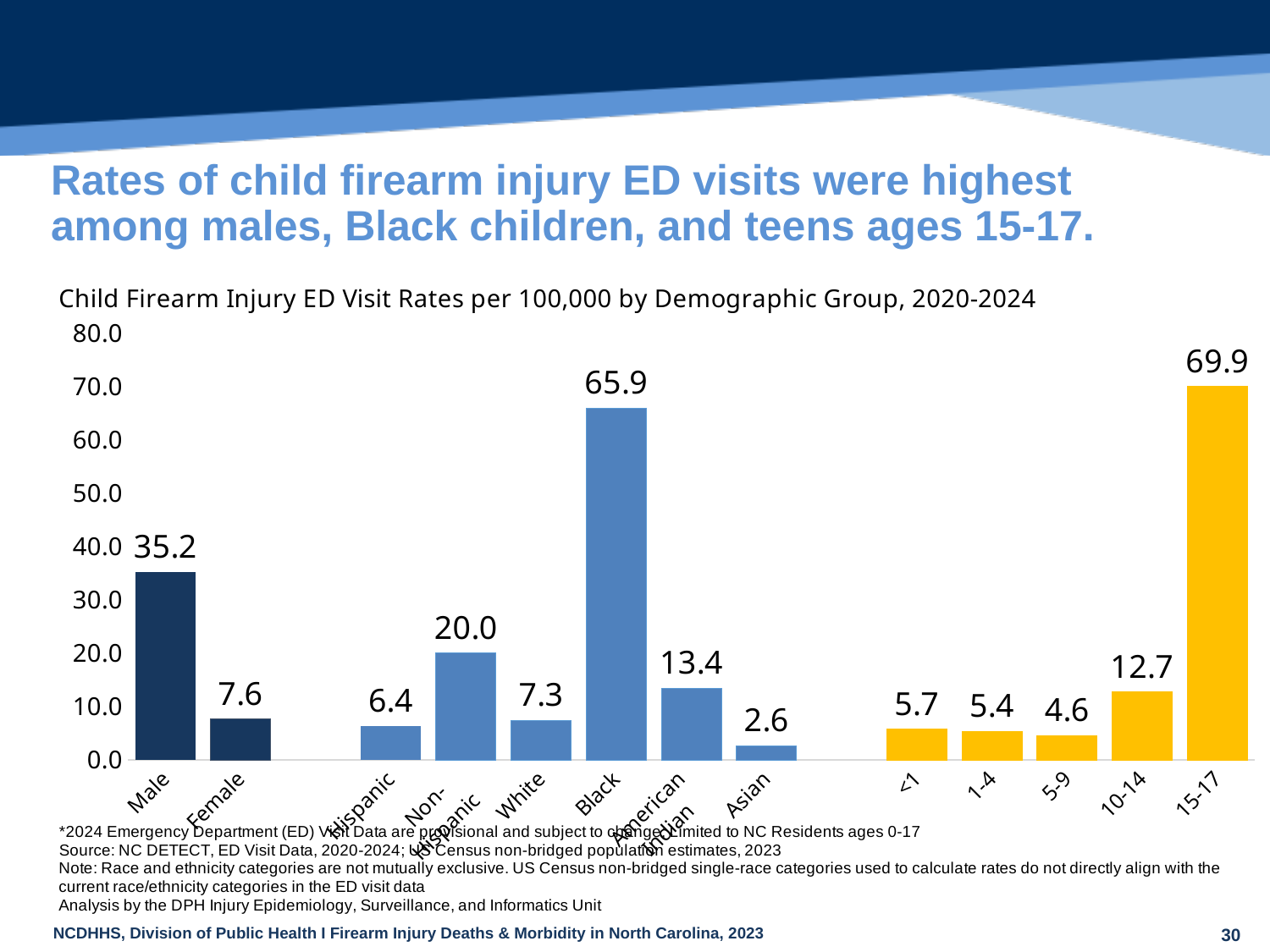
What type of chart is shown on the slide? Bar chart How many demographic groups are plotted on the chart? 13 What is the difference between the ED visit rates for the 15-17 and 10-14 age groups? 57.2 What is the title of the chart? Child Firearm Injury ED Visit Rates per 100,000 by Demographic Group, 2020-2024 What is the ED visit rate per 100,000 for males? 35.2 What is the child firearm injury ED visit rate per 100,000 for Black children? 65.9 Which demographic group has the highest ED visit rate on the chart? 15-17 What is the ED visit rate per 100,000 for the 10-14 age group? 12.7 What is the difference between the ED visit rates for males and females? 27.6 Is the ED visit rate for the 15-17 age group greater or less than 60.0? greater Which demographic group has the lowest ED visit rate on the chart? Asian Which has a higher ED visit rate, Non-Hispanic or American Indian children? Non-Hispanic